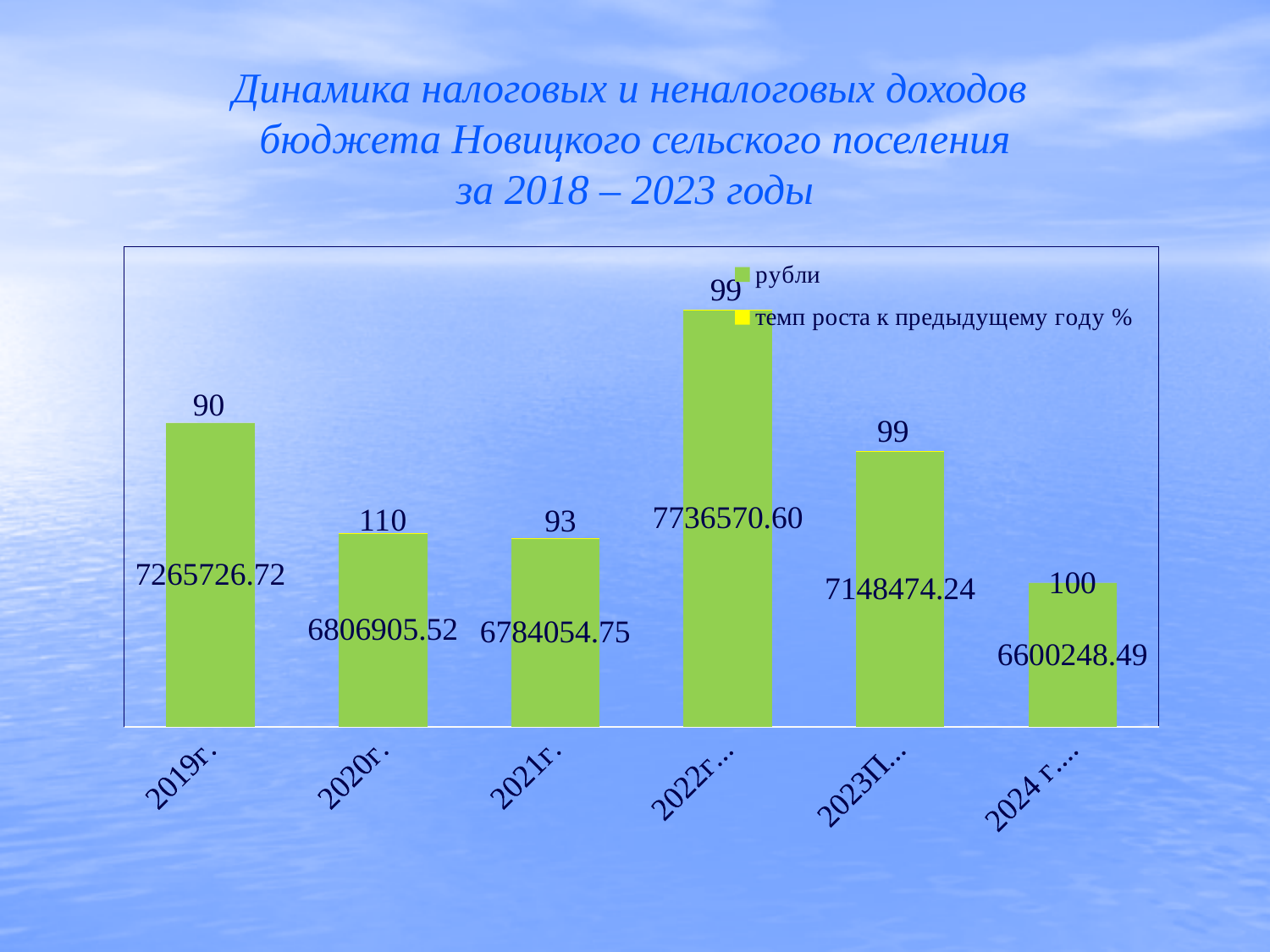
How many years are shown on the x axis? 6 What is the value of the рубли series for 2022? 7736570.60 What is the темп роста к предыдущему году % value for 2020г.? 110 Which year has the lowest темп роста к предыдущему году % value? 2019г. What kind of chart is shown on the slide? bar chart Which year has the highest рубли value? 2022 How many series does the legend list? 2 What is the difference between the рубли values for 2022 and 2024? 1136322.11 Which year has the lowest рубли value? 2024 What is the темп роста к предыдущему году % value for 2024? 100 What is the value of the рубли series for 2019г.? 7265726.72 Which is larger, the рубли value for 2021г. or for 2023? 2023